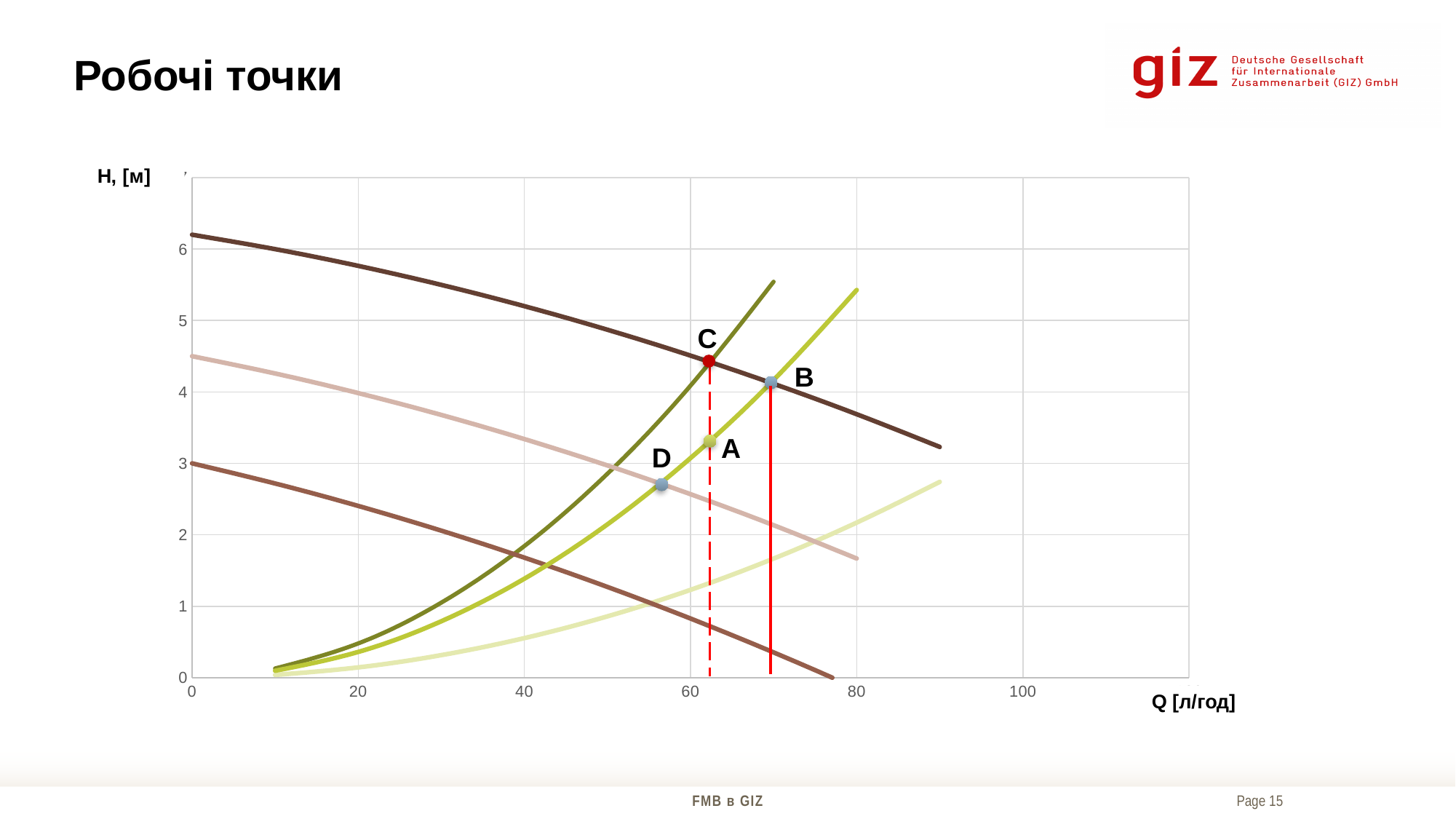
Which labeled point has the highest H value? C Is the H value at point C greater or less than 4? greater Which labeled point has the lowest H value? D What is the label of the horizontal axis? Q [л/год] Which point has a higher H value, B or D? B What kind of chart is shown on the slide? line chart Is the H value at point A greater or less than 3? greater How many labeled points (A, B, C, D) are marked on the chart? 4 Is the Q value at point B greater or less than 60? greater Which point has a higher H value, C or A? C Do the dark brown curves rise or fall as Q increases? fall